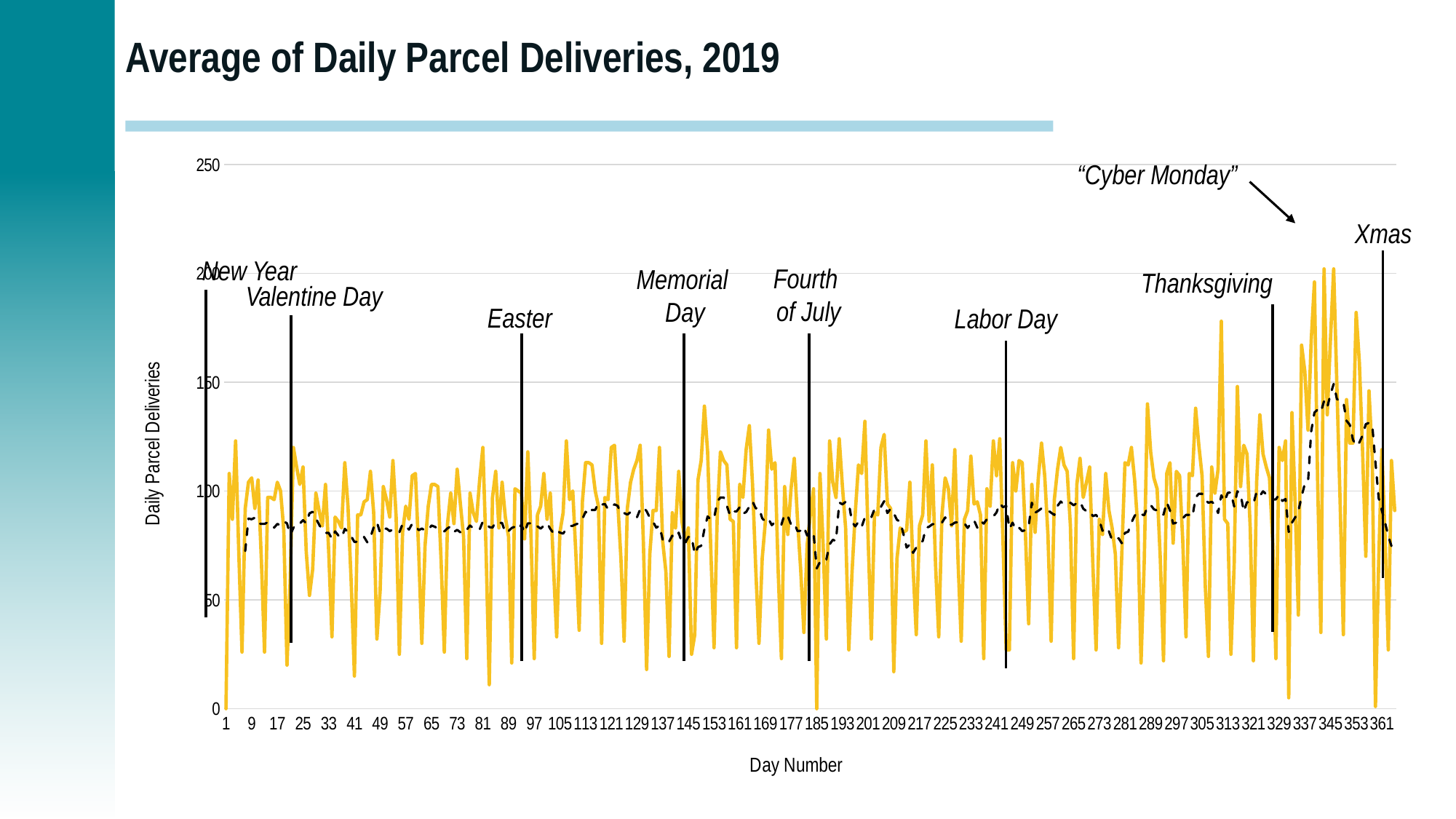
Which is larger: the dashed line's value around day 345 or around day 50? around day 345 What is the title of the chart? Average of Daily Parcel Deliveries, 2019 Between which two annotated holidays does the yellow line reach its highest peak? Cyber Monday and Xmas Is the highest peak of the yellow line greater or less than 150? greater Is the dashed line's value around day 185 (Fourth of July) greater or less than 100? less What kind of chart is shown on the slide? line chart Is the dashed line's value around day 345 greater or less than 100? greater Does the dashed line rise or fall between Thanksgiving and the peak after Cyber Monday? rise What is the label of the vertical axis? Daily Parcel Deliveries What is the highest value shown on the vertical axis? 250 How many holiday annotations are labelled on the chart? 9